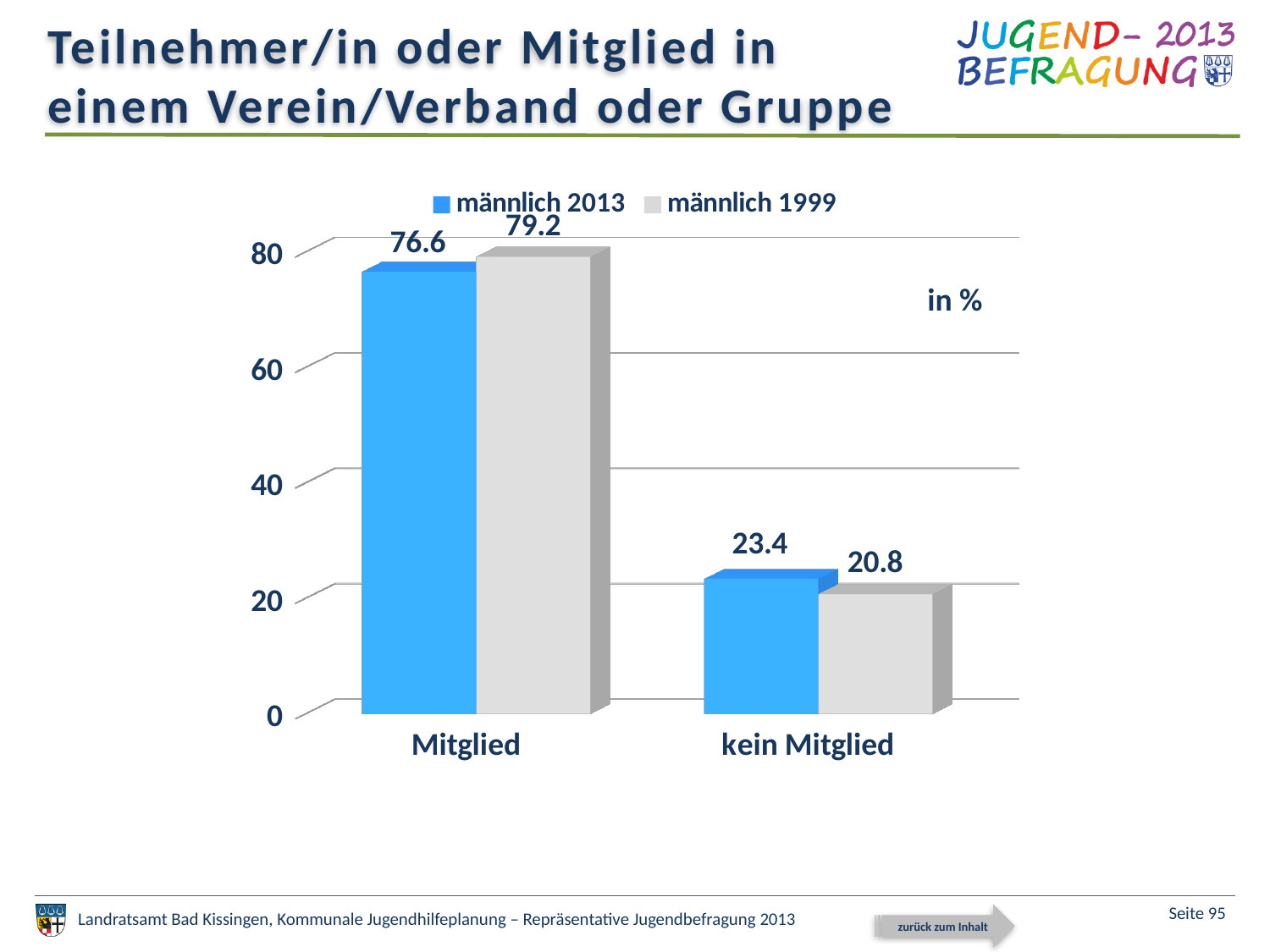
How many categories are shown on the x axis? 2 Is the value for 'männlich 2013' in the 'kein Mitglied' category greater or less than 40? less What is the value for 'männlich 1999' in the 'kein Mitglied' category? 20.8 What is the difference between the 'männlich 1999' and 'männlich 2013' values in the 'Mitglied' category? 2.6 What kind of chart is shown on the slide? Bar chart How many series does the legend list? 2 What is the value for 'männlich 2013' in the 'Mitglied' category? 76.6 What is the value for 'männlich 1999' in the 'Mitglied' category? 79.2 Which series has the higher value in the 'kein Mitglied' category? männlich 2013 What is the difference between the 'männlich 2013' and 'männlich 1999' values in the 'kein Mitglied' category? 2.6 What is the value for 'männlich 2013' in the 'kein Mitglied' category? 23.4 Which series has the higher value in the 'Mitglied' category? männlich 1999